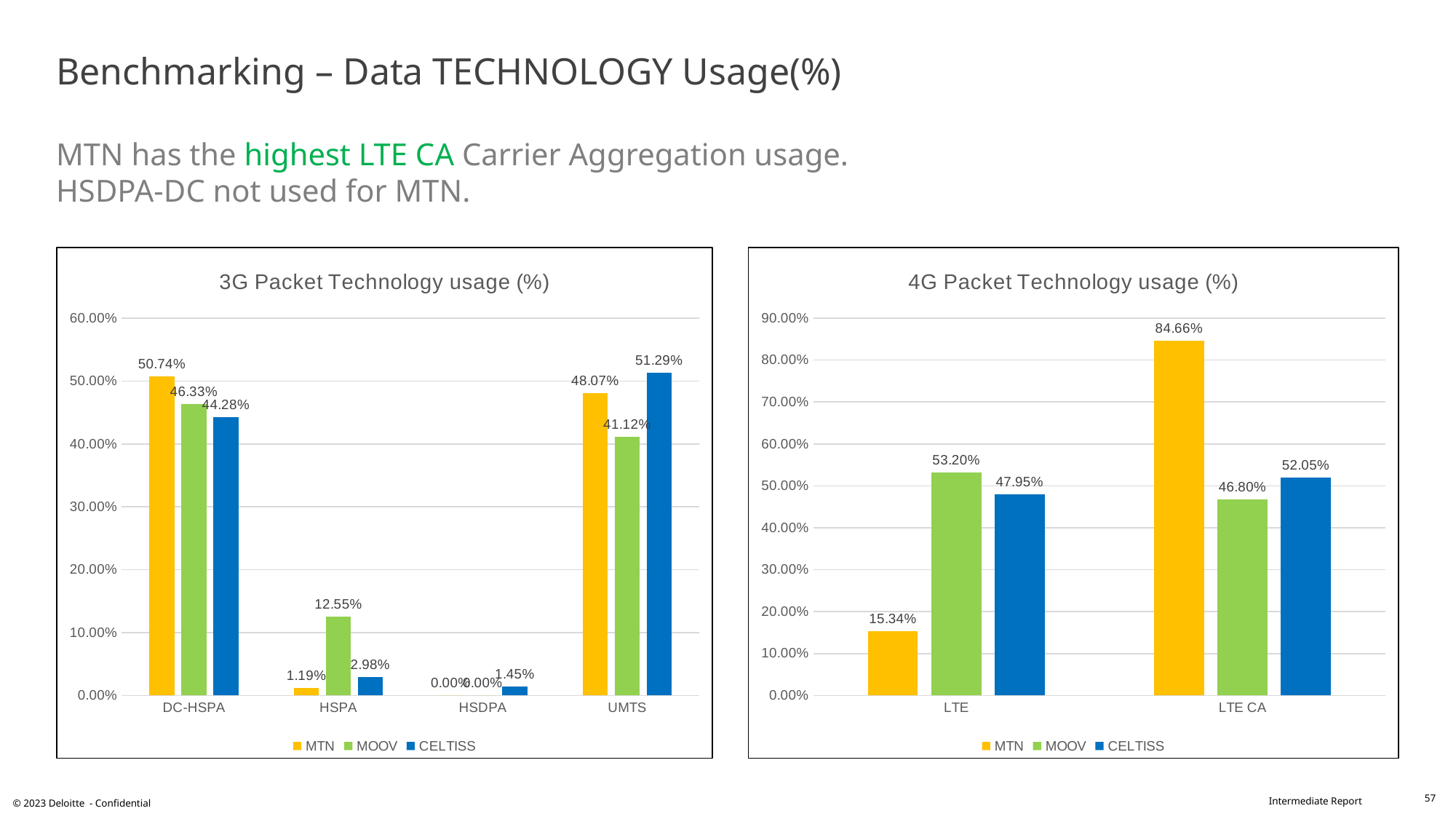
In the 3G Packet Technology usage chart, what is the MTN value for DC-HSPA? 50.74% In the 3G Packet Technology usage chart, which operator has the highest value for UMTS? CELTISS In the 4G Packet Technology usage chart, what is the CELTISS value for LTE? 47.95% In the 3G Packet Technology usage chart, what is the MOOV value for HSPA? 12.55% In the 4G Packet Technology usage chart, which operator has the lowest value for LTE? MTN In the 3G Packet Technology usage chart, how many technology categories are shown on the x axis? 4 In the 3G Packet Technology usage chart, what is the difference between the CELTISS and MTN values for UMTS? 3.22% In the 4G Packet Technology usage chart, is the MOOV value for LTE larger or the MOOV value for LTE CA? LTE How many series does the legend of the 4G Packet Technology usage chart list? 3 In the 4G Packet Technology usage chart, what is the MTN value for LTE CA? 84.66% In the 4G Packet Technology usage chart, what is the difference between the MTN values for LTE CA and LTE? 69.32% In the 3G Packet Technology usage chart, which operator has the lowest value for DC-HSPA? CELTISS